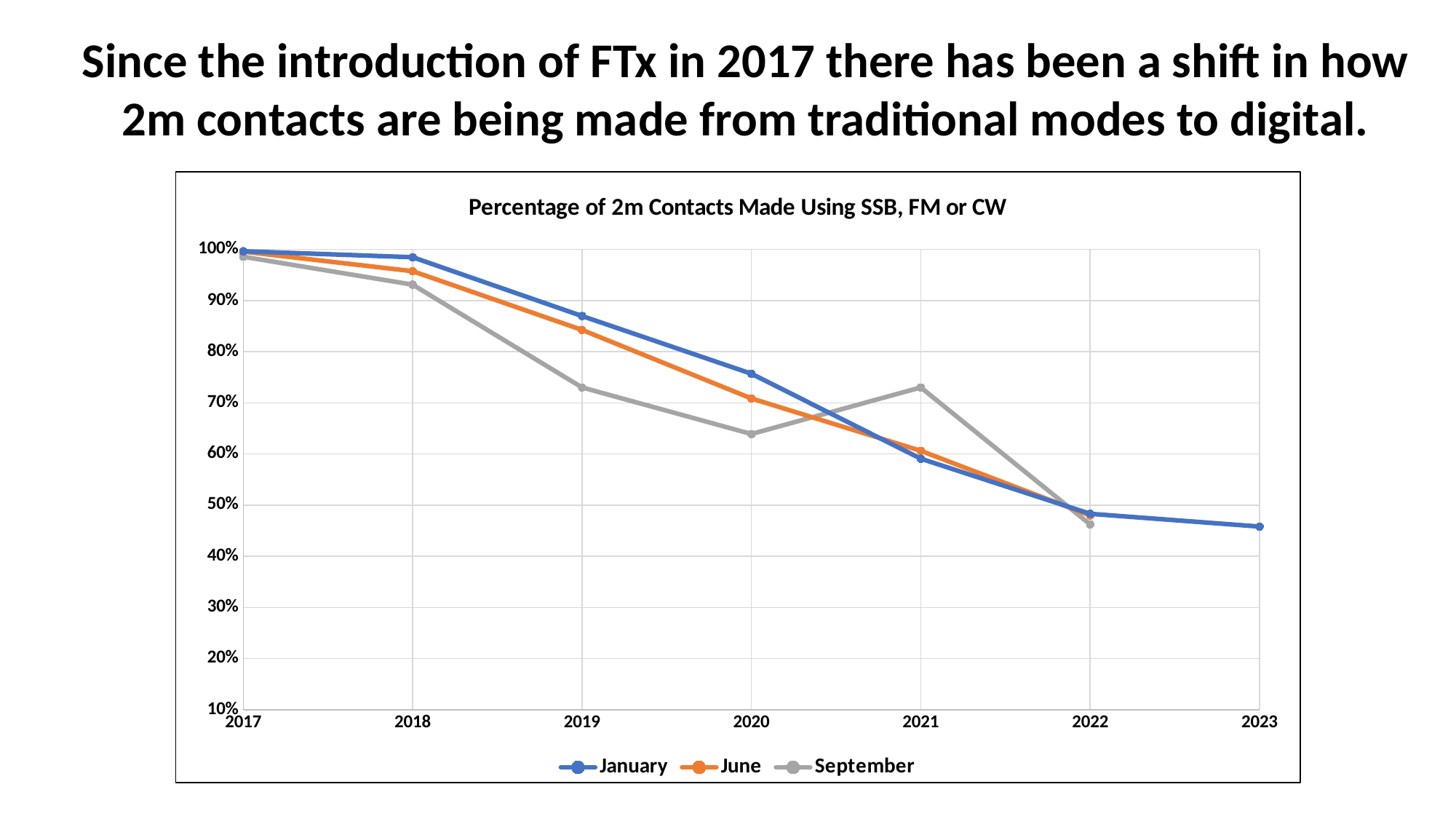
Which series has the lowest value in 2019? September What is the title of the chart? Percentage of 2m Contacts Made Using SSB, FM or CW How many years are shown on the x axis? 7 Which series has the highest value in 2020? January In 2019, which is larger: the January value or the September value? January Is the January value for 2020 greater or less than 70%? greater Is the September value for 2020 greater or less than 70%? less What kind of chart is shown on the slide? Line chart In 2021, which is larger: the September value or the January value? September Does the January series rise or fall from 2017 to 2023? Fall How many series does the legend list? 3 Is the January value for 2023 greater or less than 50%? less